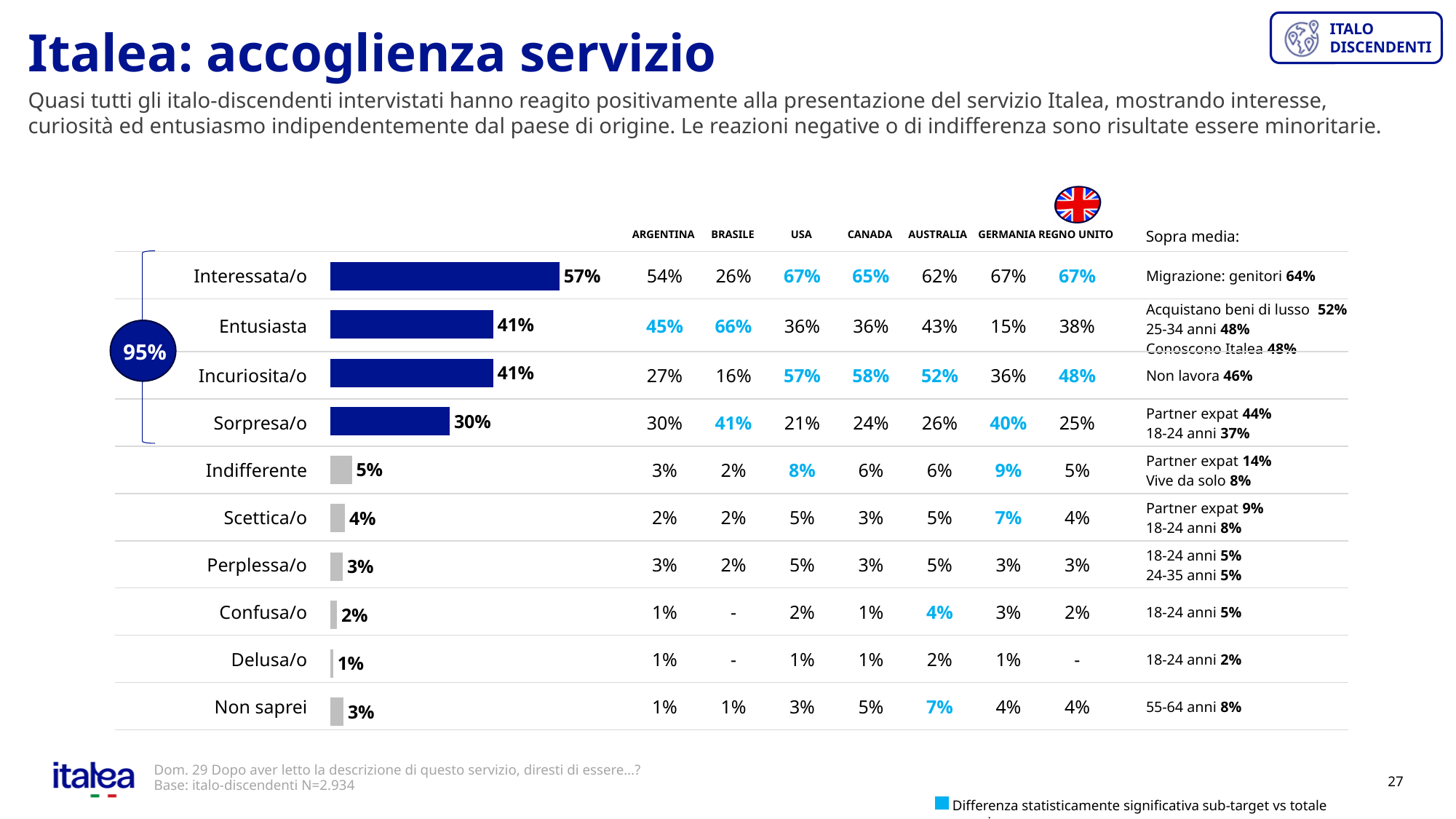
What is the value for Entusiasta in the bar chart? 41% What is the difference between the values for Indifferente and Delusa/o in the bar chart? 4% What is the difference between the values for Interessata/o and Sorpresa/o in the bar chart? 27% What percentage is shown in the circle to the left of the top four bars? 95% Which is larger in the bar chart, Scettica/o or Perplessa/o? Scettica/o How many categories are shown in the bar chart? 10 What is the value for Interessata/o in the bar chart? 57% Which category has the lowest value in the bar chart? Delusa/o What is the value for Indifferente in the bar chart? 5% What kind of chart is shown on the slide? bar chart What is the value for Sorpresa/o in the bar chart? 30% Which category has the highest value in the bar chart? Interessata/o